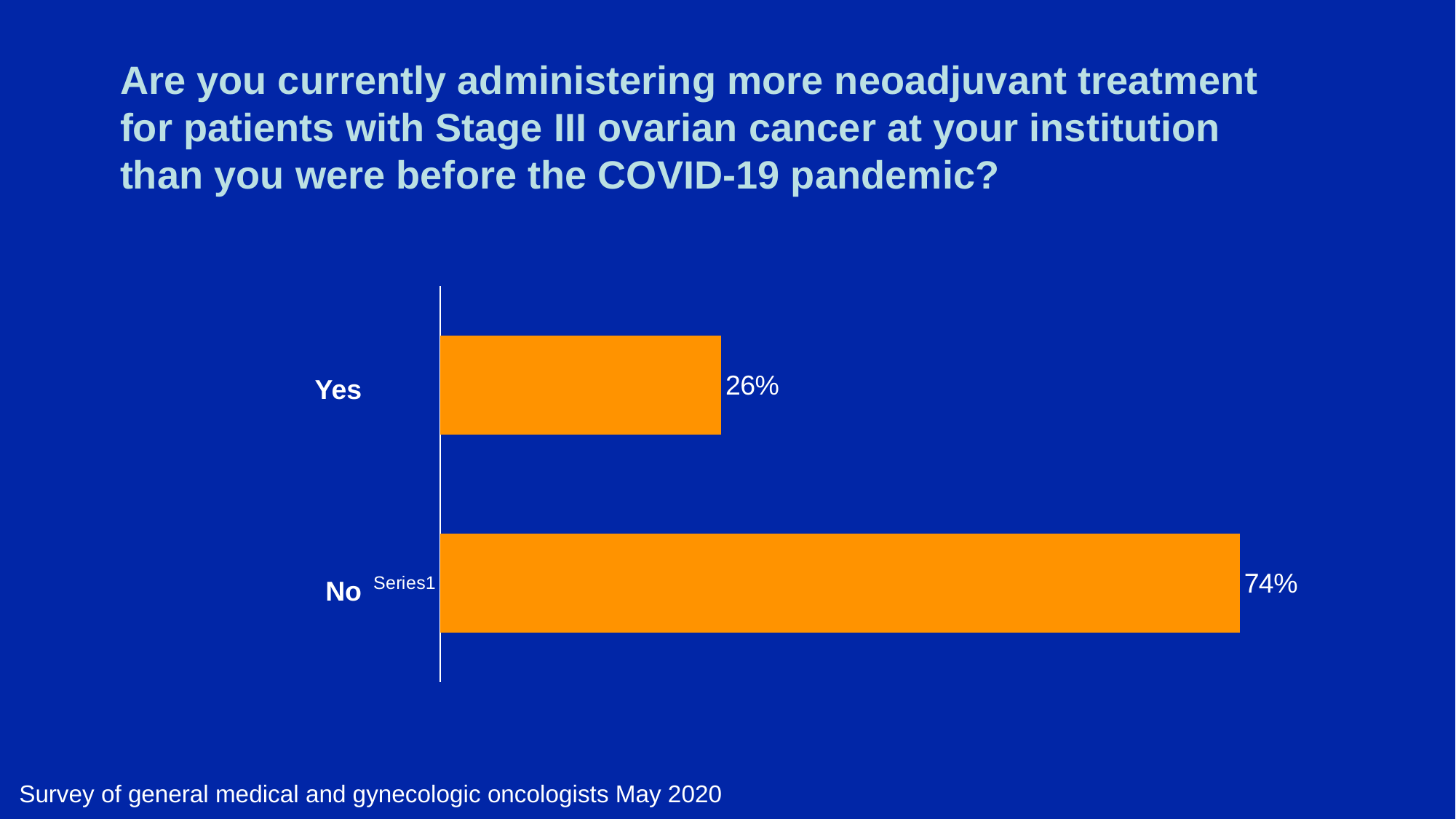
What colour are the bars in the chart? orange What percentage of respondents answered Yes? 26% What percentage of respondents answered No? 74% How many response categories are shown in the chart? 2 What kind of chart is shown on the slide? bar chart Which response has the higher percentage, Yes or No? No According to the footnote, who was surveyed and when? General medical and gynecologic oncologists, May 2020 What is the total of the Yes and No percentages? 100% What is the difference in percentage points between the No and Yes responses? 48 Which response has the lowest percentage? Yes Is the value for Yes larger or smaller than the value for No? smaller